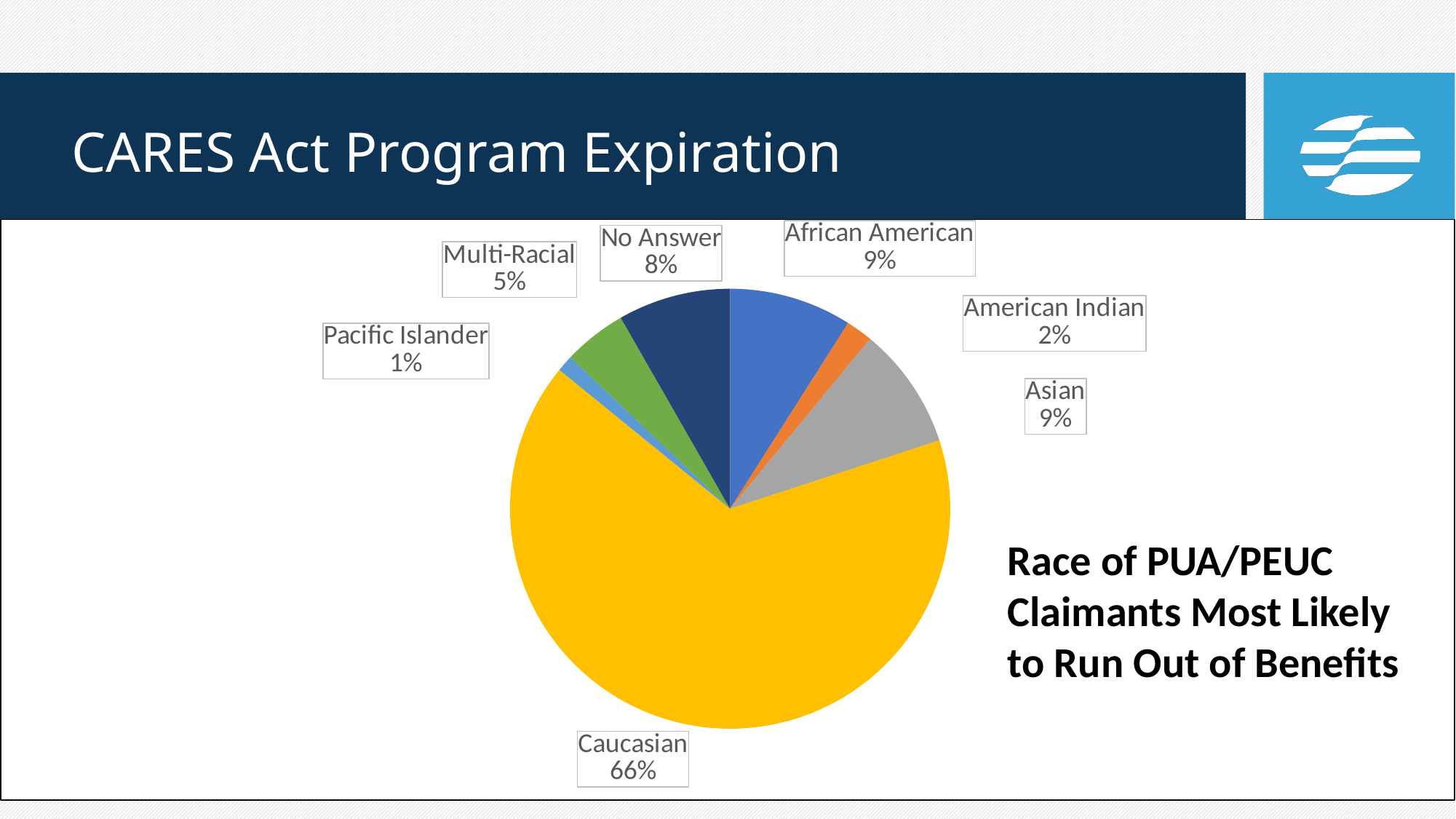
What kind of chart is shown on the slide? Pie chart What is the value for African American? 9% What colour is the Caucasian slice? Yellow Which is larger, the share for Multi-Racial or the share for No Answer? No Answer What is the value for Pacific Islander? 1% Which category has the smallest slice of the pie? Pacific Islander Which category has the largest slice of the pie? Caucasian What is the value for No Answer? 8% How many categories are shown in the pie chart? 7 What share of the pie does Caucasian represent? 66% What is the difference between the Caucasian share and the Asian share? 57% What is the value for American Indian? 2%